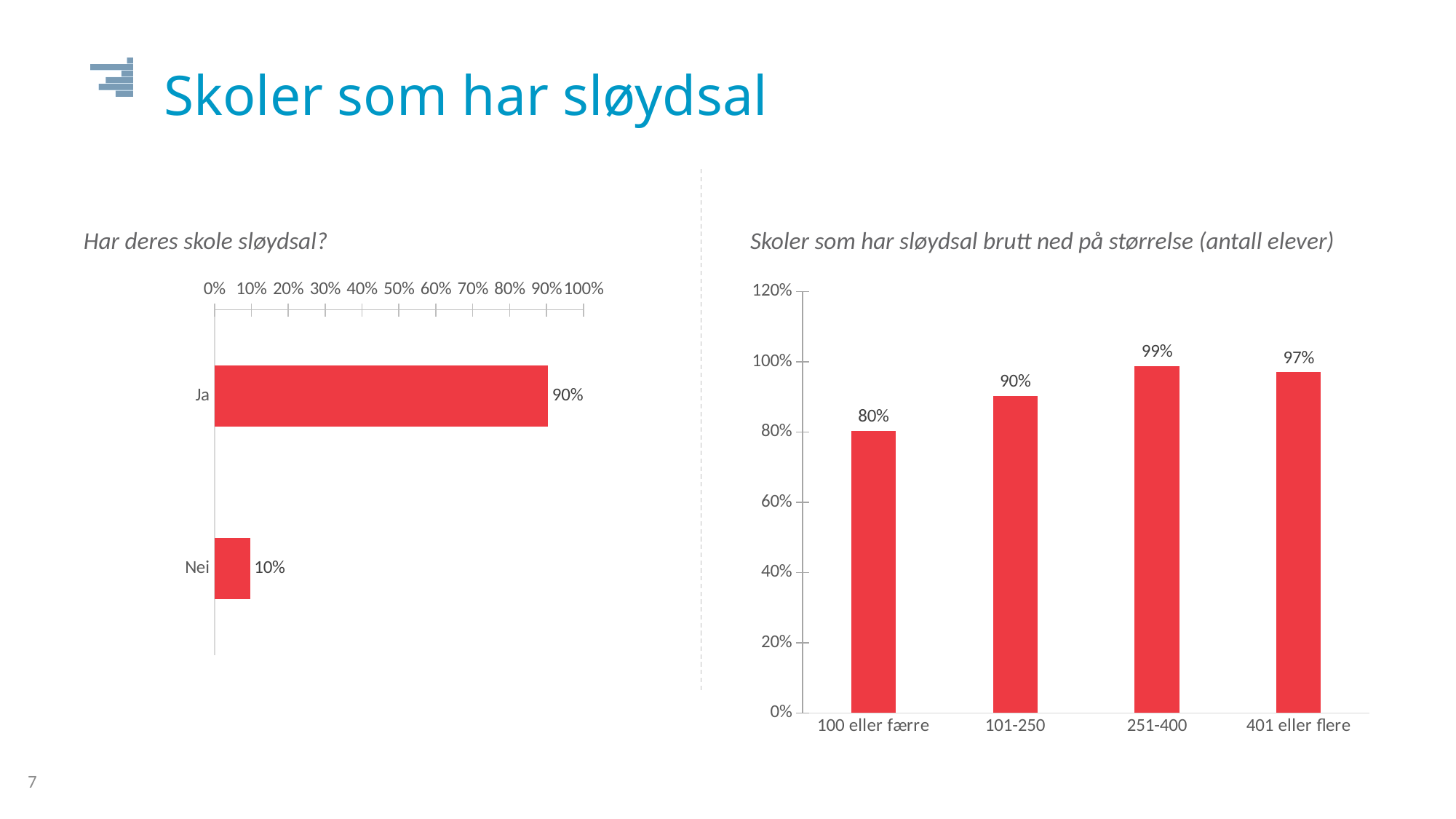
In the right chart 'Skoler som har sløydsal brutt ned på størrelse (antall elever)', what is the value for '100 eller færre'? 80% In the right chart 'Skoler som har sløydsal brutt ned på størrelse (antall elever)', which is larger: the value for '101-250' or '401 eller flere'? 401 eller flere In the left chart 'Har deres skole sløydsal?', what is the value for 'Nei'? 10% In the right chart 'Skoler som har sløydsal brutt ned på størrelse (antall elever)', what is the value for '401 eller flere'? 97% In the left chart 'Har deres skole sløydsal?', what is the difference between the 'Ja' and 'Nei' values? 80% What kind of chart is the left chart 'Har deres skole sløydsal?'? Bar chart In the right chart 'Skoler som har sløydsal brutt ned på størrelse (antall elever)', how many categories are shown on the x axis? 4 In the left chart 'Har deres skole sløydsal?', how many categories are shown? 2 In the right chart 'Skoler som har sløydsal brutt ned på størrelse (antall elever)', what is the difference between the values for '251-400' and '101-250'? 9% In the left chart 'Har deres skole sløydsal?', what is the value for 'Ja'? 90% In the right chart 'Skoler som har sløydsal brutt ned på størrelse (antall elever)', which category has the highest value? 251-400 In the right chart 'Skoler som har sløydsal brutt ned på størrelse (antall elever)', which category has the lowest value? 100 eller færre